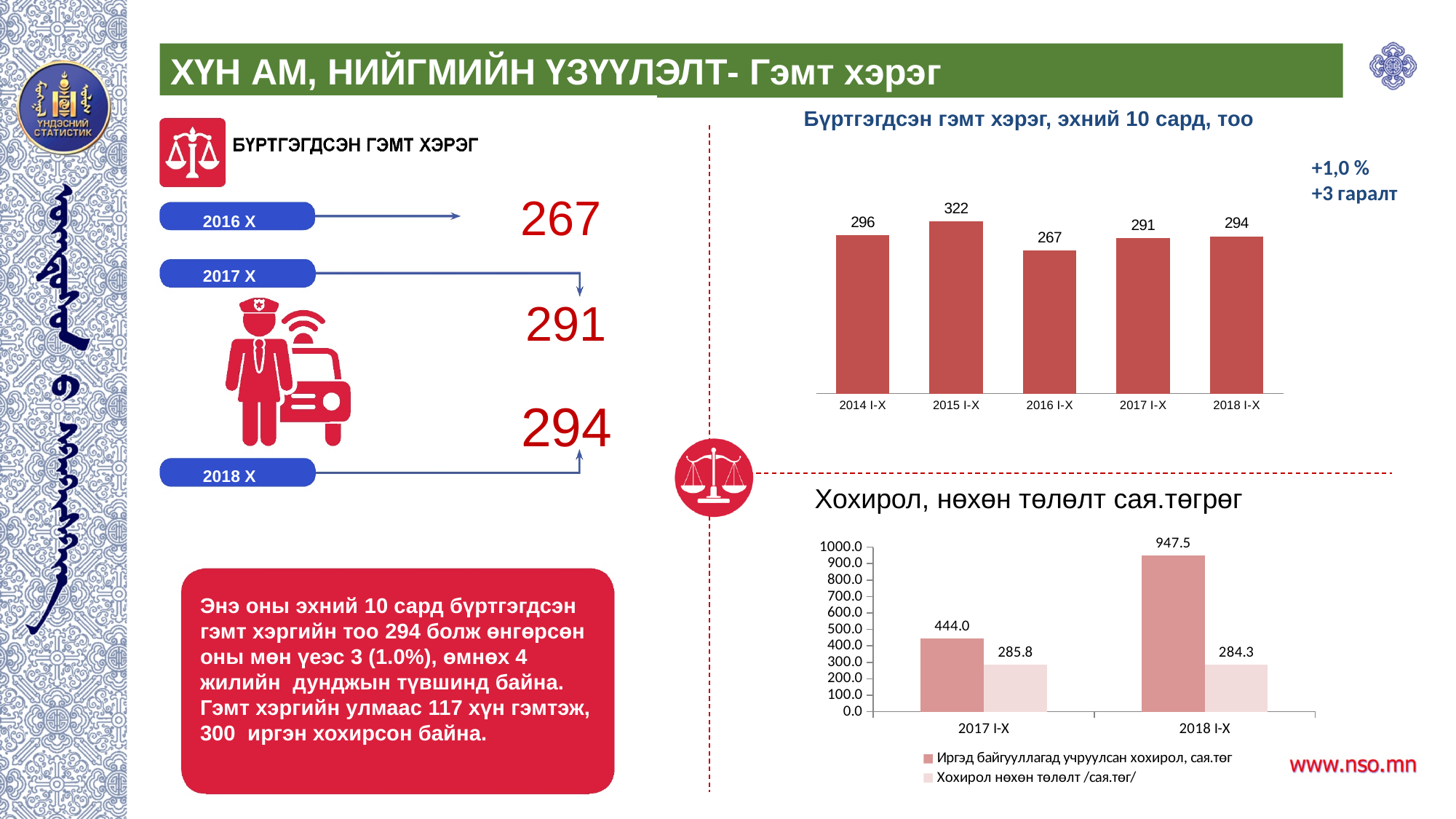
In the chart titled 'Бүртгэгдсэн гэмт хэрэг, эхний 10 сард, тоо', how many periods are shown on the x axis? 5 In the chart titled 'Хохирол, нөхөн төлөлт сая.төгрөг', what is the value of 'Хохирол нөхөн төлөлт /сая.төг/' for 2017 I-X? 285.8 In the chart titled 'Хохирол, нөхөн төлөлт сая.төгрөг', does the 'Иргэд байгууллагад учруулсан хохирол, сая.төг' series rise or fall from 2017 I-X to 2018 I-X? rise In the chart titled 'Хохирол, нөхөн төлөлт сая.төгрөг', how many series does the legend list? 2 What kind of chart is the one titled 'Хохирол, нөхөн төлөлт сая.төгрөг'? bar chart In the chart titled 'Бүртгэгдсэн гэмт хэрэг, эхний 10 сард, тоо', which period has the lowest value? 2016 I-X In the chart titled 'Бүртгэгдсэн гэмт хэрэг, эхний 10 сард, тоо', what is the difference between the values for 2015 I-X and 2016 I-X? 55 In the chart titled 'Бүртгэгдсэн гэмт хэрэг, эхний 10 сард, тоо', what is the value for 2015 I-X? 322 In the chart titled 'Хохирол, нөхөн төлөлт сая.төгрөг', what is the value of 'Иргэд байгууллагад учруулсан хохирол, сая.төг' for 2018 I-X? 947.5 In the chart titled 'Бүртгэгдсэн гэмт хэрэг, эхний 10 сард, тоо', which period has the highest value? 2015 I-X In the chart titled 'Бүртгэгдсэн гэмт хэрэг, эхний 10 сард, тоо', is the value for 2014 I-X larger or smaller than the value for 2018 I-X? larger In the chart titled 'Хохирол, нөхөн төлөлт сая.төгрөг', what is the difference between the 'Иргэд байгууллагад учруулсан хохирол, сая.төг' values for 2018 I-X and 2017 I-X? 503.5